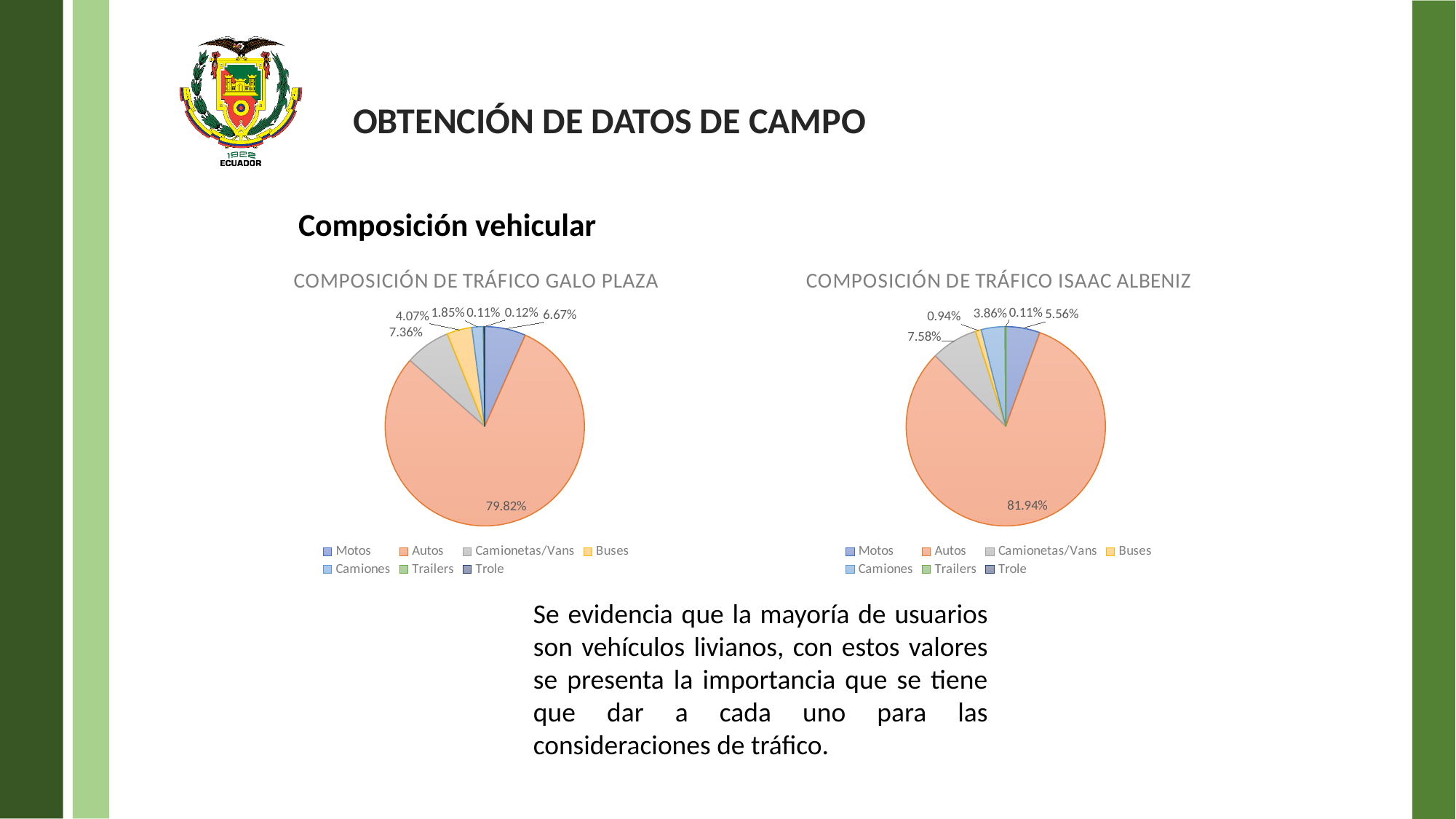
In the COMPOSICIÓN DE TRÁFICO GALO PLAZA chart, which category has the largest share? Autos In the COMPOSICIÓN DE TRÁFICO ISAAC ALBENIZ chart, what is the share for Motos? 5.56% In the COMPOSICIÓN DE TRÁFICO GALO PLAZA chart, what is the share for Camionetas/Vans? 7.36% In the COMPOSICIÓN DE TRÁFICO ISAAC ALBENIZ chart, what share do Autos have? 81.94% In the COMPOSICIÓN DE TRÁFICO ISAAC ALBENIZ chart, which category has the largest share? Autos In the COMPOSICIÓN DE TRÁFICO GALO PLAZA chart, what share do Autos have? 79.82% In the COMPOSICIÓN DE TRÁFICO ISAAC ALBENIZ chart, which is larger, the share for Camionetas/Vans or the share for Motos? Camionetas/Vans What type of chart is used for COMPOSICIÓN DE TRÁFICO GALO PLAZA? Pie chart In the COMPOSICIÓN DE TRÁFICO GALO PLAZA chart, what is the difference between the Autos share and the Motos share? 73.15% How many categories does the legend of the COMPOSICIÓN DE TRÁFICO ISAAC ALBENIZ chart list? 7 In the COMPOSICIÓN DE TRÁFICO GALO PLAZA chart, what is the share for Buses? 4.07% In the COMPOSICIÓN DE TRÁFICO ISAAC ALBENIZ chart, what is the share for Camiones? 3.86%